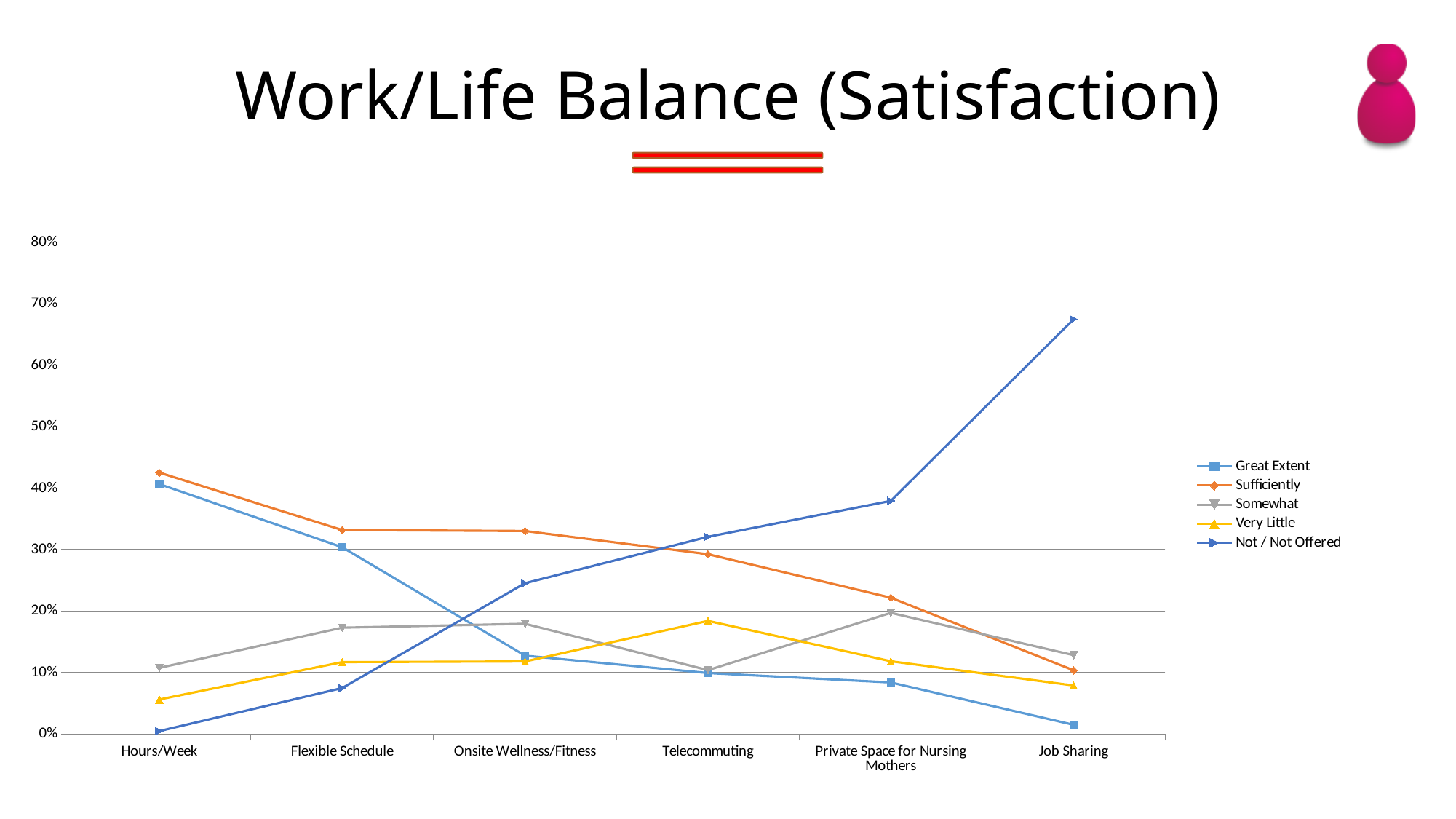
Is the value for Great Extent at Job Sharing greater or less than 10%? less Which category has the highest value for the Great Extent series? Hours/Week Does the Great Extent series rise or fall from Hours/Week to Job Sharing? fall How many series does the legend list? 5 What kind of chart is shown on the slide? line chart Does the Not / Not Offered series rise or fall from Hours/Week to Job Sharing? rise Which category has the lowest value for the Not / Not Offered series? Hours/Week Is the value for Sufficiently at Hours/Week greater or less than 40%? greater Is the value for Not / Not Offered at Job Sharing greater or less than 60%? greater At Private Space for Nursing Mothers, which is larger: Somewhat or Very Little? Somewhat How many categories are shown on the x axis? 6 Which category has the highest value for the Not / Not Offered series? Job Sharing